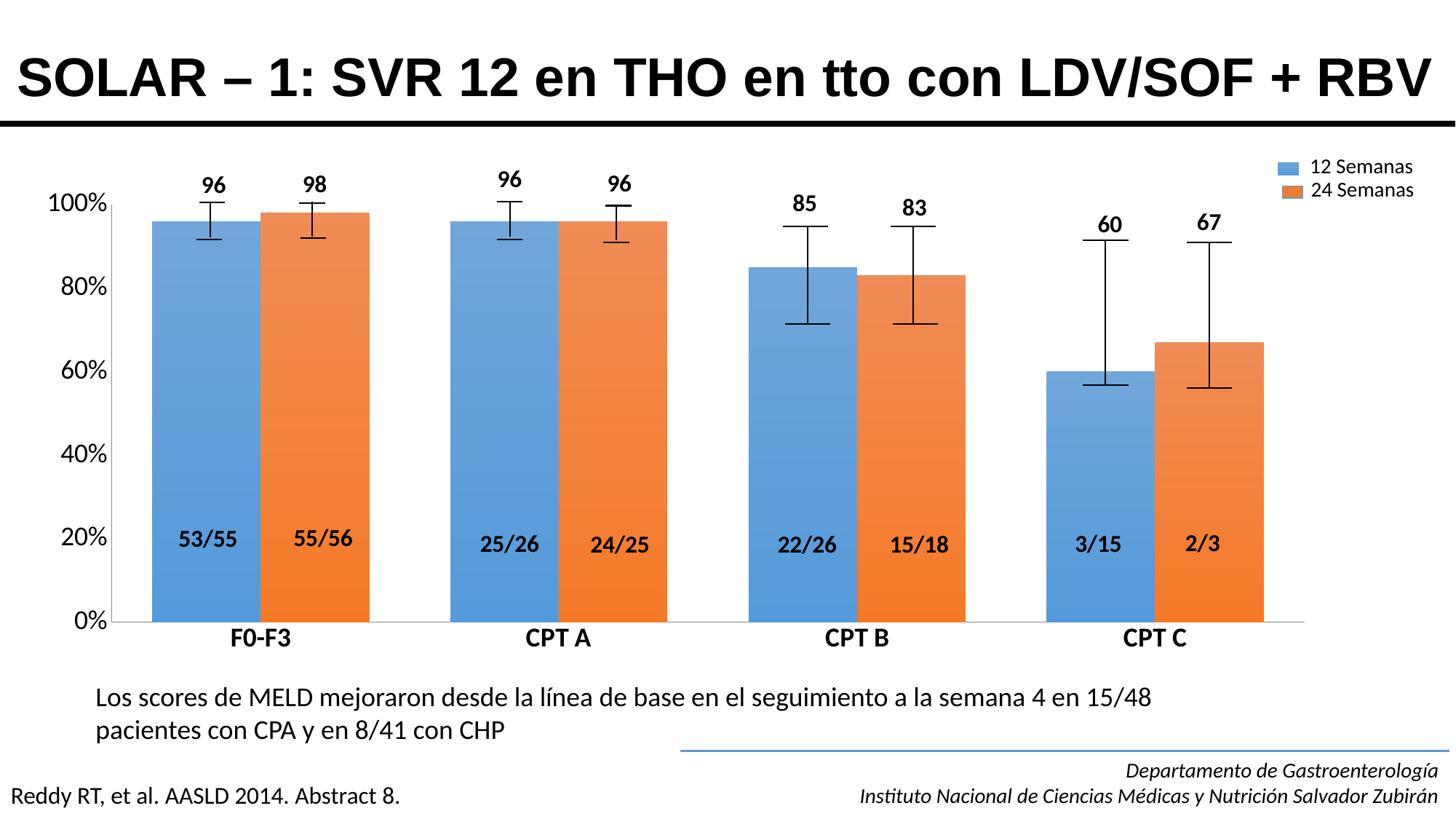
What is the value for 12 Semanas in the CPT B category? 85 What is the difference between the 24 Semanas and 12 Semanas values for CPT C? 7 What is the value for 24 Semanas in the F0-F3 category? 98 Is the value for 12 Semanas in CPT C greater or less than 80%? less Which category has the lowest value for 12 Semanas? CPT C Which is larger for CPT B: the 12 Semanas value or the 24 Semanas value? 12 Semanas What kind of chart is shown on the slide? bar chart What fraction is printed inside the 24 Semanas bar for CPT C? 2/3 Which colour represents the 24 Semanas series? orange How many series does the legend list? 2 Which category has the highest value for 24 Semanas? F0-F3 How many categories are shown on the x axis? 4